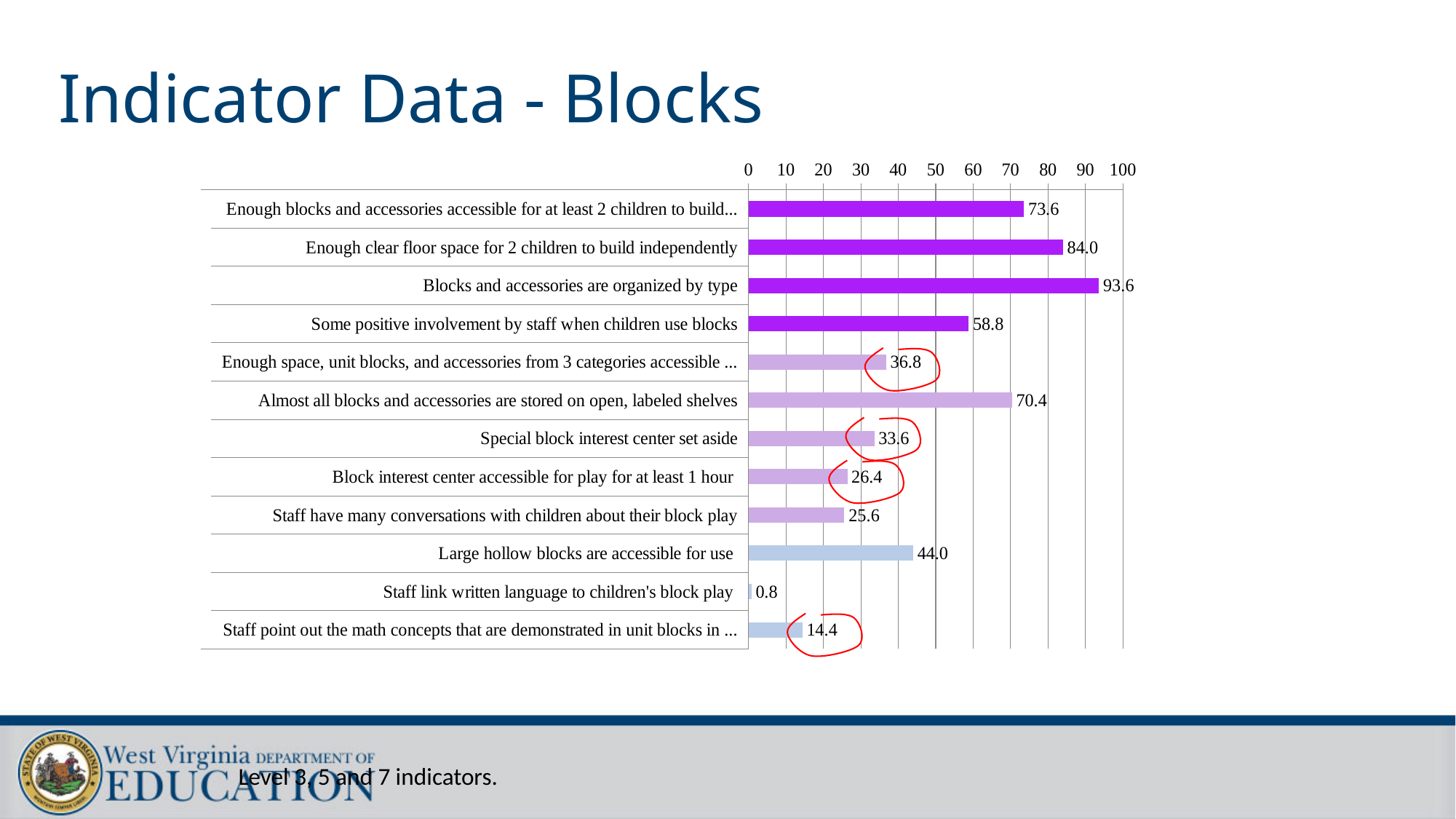
Which category has the lowest value? Staff link written language to children's block play How many categories are shown in the chart? 12 What is the value for "Blocks and accessories are organized by type"? 93.6 Which category has the highest value? Blocks and accessories are organized by type Which is larger: the value for "Almost all blocks and accessories are stored on open, labeled shelves" or the value for "Some positive involvement by staff when children use blocks"? Almost all blocks and accessories are stored on open, labeled shelves What is the value for "Staff link written language to children's block play"? 0.8 Is the value for "Staff have many conversations with children about their block play" greater or less than 30? less What kind of chart is shown on the slide? bar chart What is the difference between the values for "Enough clear floor space for 2 children to build independently" and "Enough blocks and accessories accessible for at least 2 children to build..."? 10.4 What is the value for "Special block interest center set aside"? 33.6 What is the title of the slide containing the chart? Indicator Data - Blocks What is the value for "Large hollow blocks are accessible for use"? 44.0